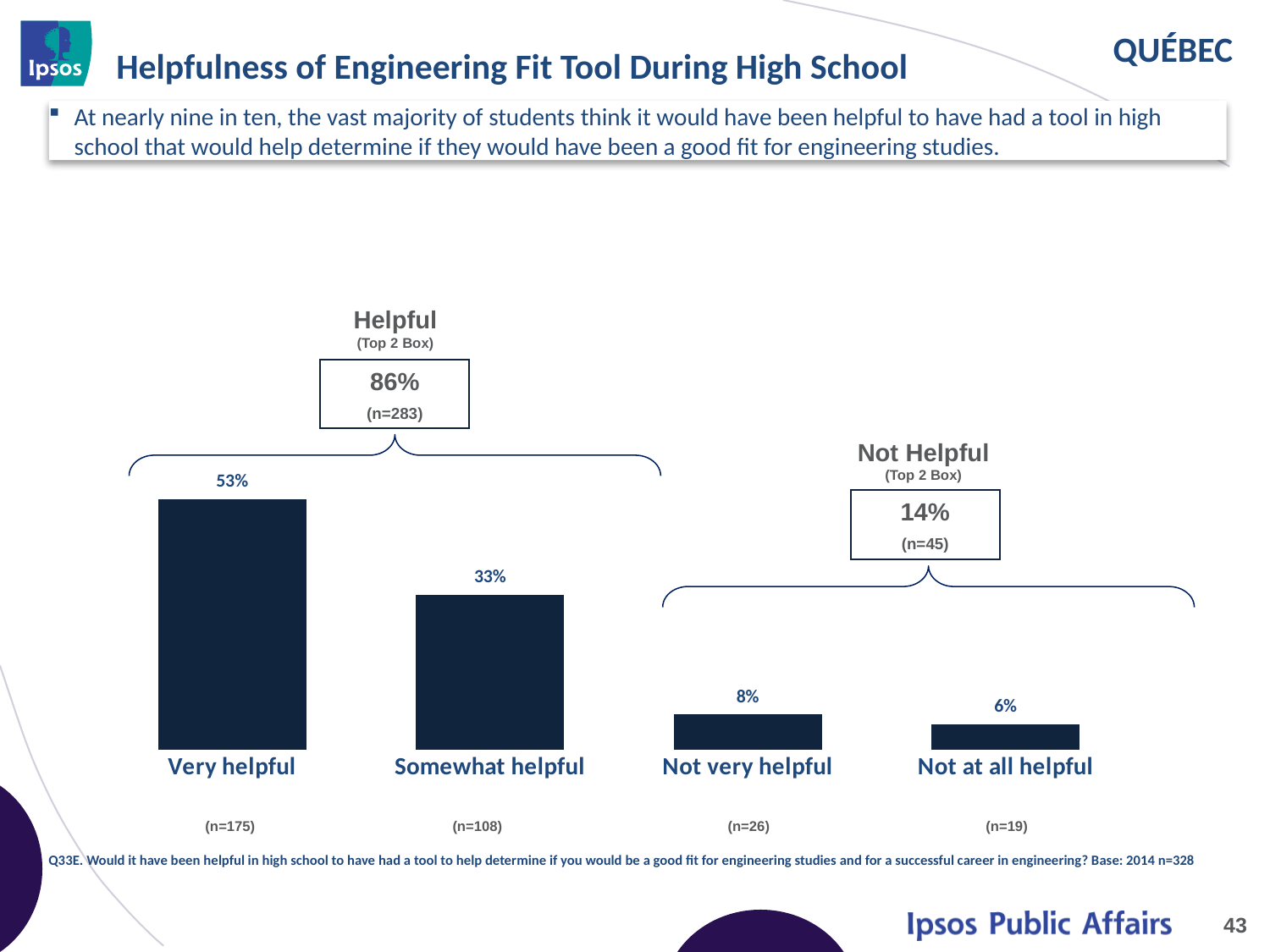
Which is larger, the value for Not very helpful or the value for Not at all helpful? Not very helpful What percentage of students said a tool would have been very helpful? 53% What percentage of students said a tool would have been not very helpful? 8% What is the sample size (n) shown for the Not Helpful (Top 2 Box) group? n=45 What kind of chart is shown on the slide? Bar chart What is the difference in percentage points between Very helpful and Somewhat helpful? 20 Which category has the lowest percentage? Not at all helpful Which category has the highest percentage? Very helpful What percentage of students said a tool would have been somewhat helpful? 33% What percentage of students said a tool would have been not at all helpful? 6% How many categories are shown in the chart? 4 What is the Helpful (Top 2 Box) percentage shown above the chart? 86%